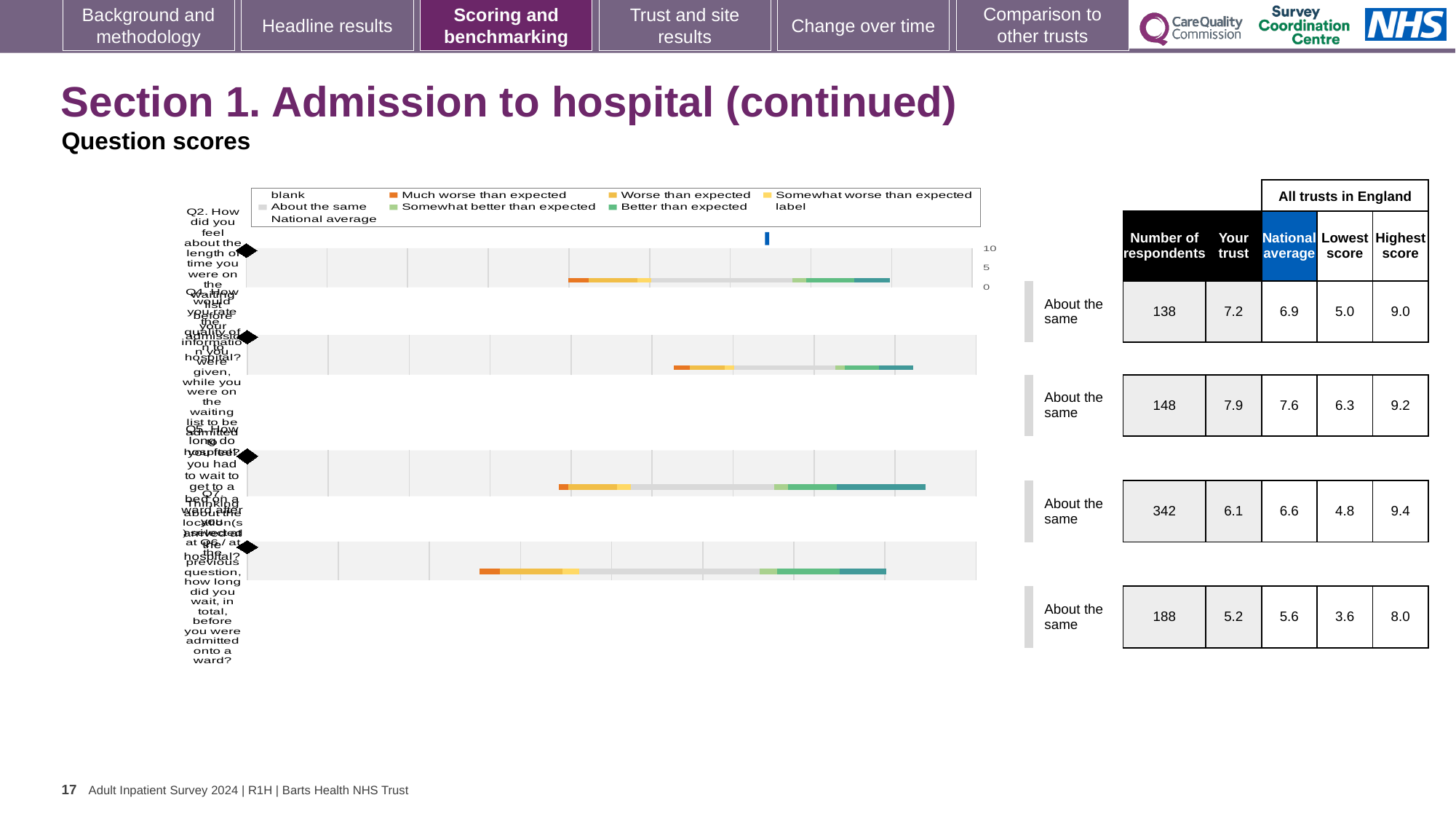
Which legend entry is shown in dark orange on the chart? Much worse than expected How many question rows (bars) does the chart show? 4 What is the maximum value shown on the chart's score axis? 10 What benchmark category is given for every question row on the slide? About the same In the table beside the chart, what is the lowest score for the fourth row? 3.6 In the table beside the chart, which row has the highest number of respondents? third row (342) What kind of chart is shown on the slide? bar chart In the table beside the chart, what is the 'Your trust' score for the first row? 7.2 In the table beside the chart, what is the difference between the highest score and lowest score in the third row? 4.6 In the table beside the chart, what is the national average for the second row? 7.6 In the table beside the chart, is the 'Your trust' score in the first row larger or smaller than the national average in that row? larger In the table beside the chart, which row has the lowest 'Your trust' score? fourth row (5.2)